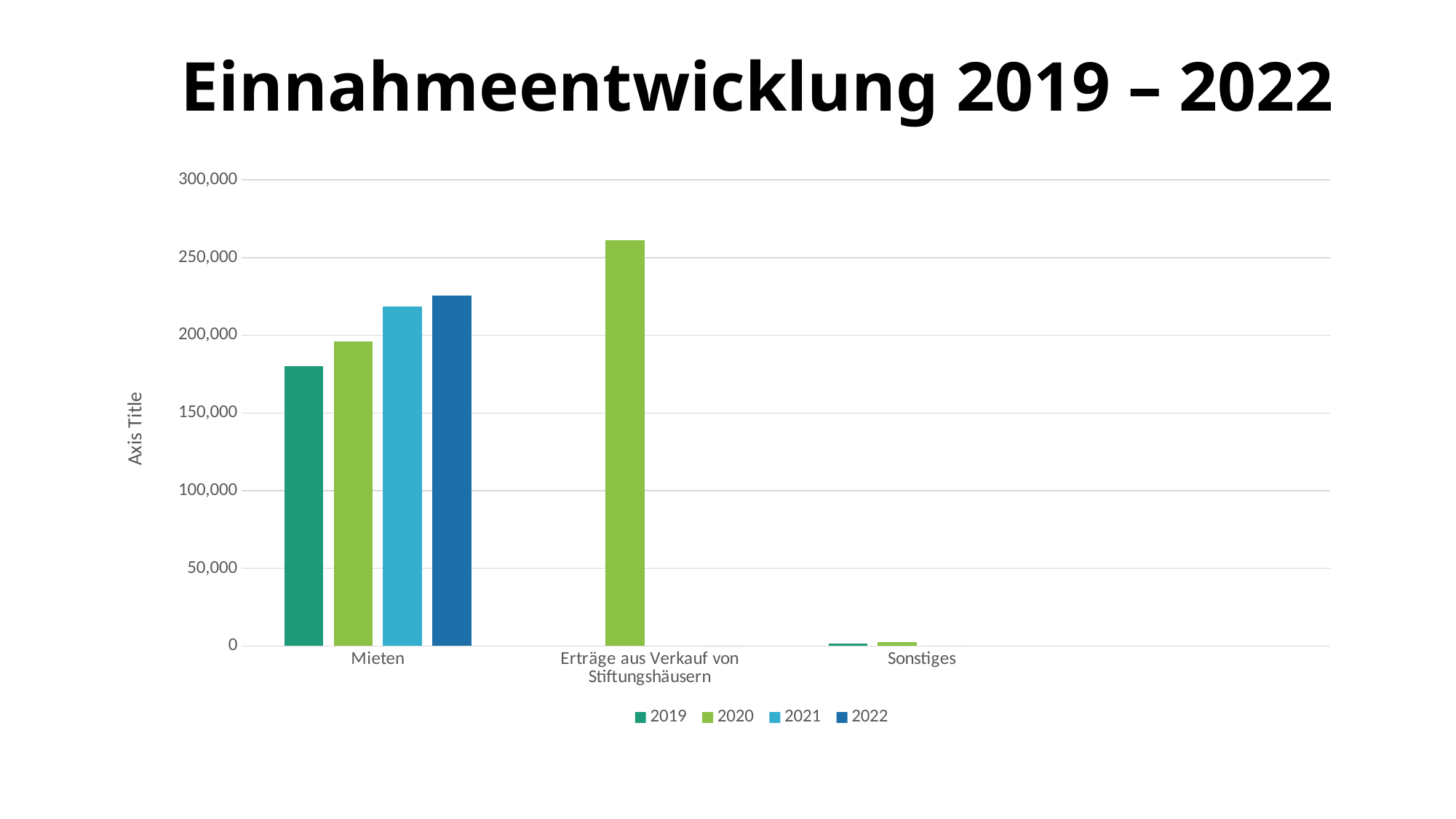
Which series are listed in the legend? 2019, 2020, 2021, 2022 What is the title of the chart? Einnahmeentwicklung 2019 – 2022 Which is larger: the 2020 value for Mieten or the 2020 value for Erträge aus Verkauf von Stiftungshäusern? Erträge aus Verkauf von Stiftungshäusern How many categories are shown on the x axis? 3 Is the value for Erträge aus Verkauf von Stiftungshäusern in 2020 greater or less than 250,000? greater For the category Mieten, do the values rise or fall from 2019 to 2022? rise What kind of chart is shown on the slide? bar chart How many series does the legend list? 4 Is the value for Sonstiges in 2020 greater or less than 50,000? less Is the value for Mieten in 2019 greater or less than 150,000? greater Which category has the lowest values overall? Sonstiges